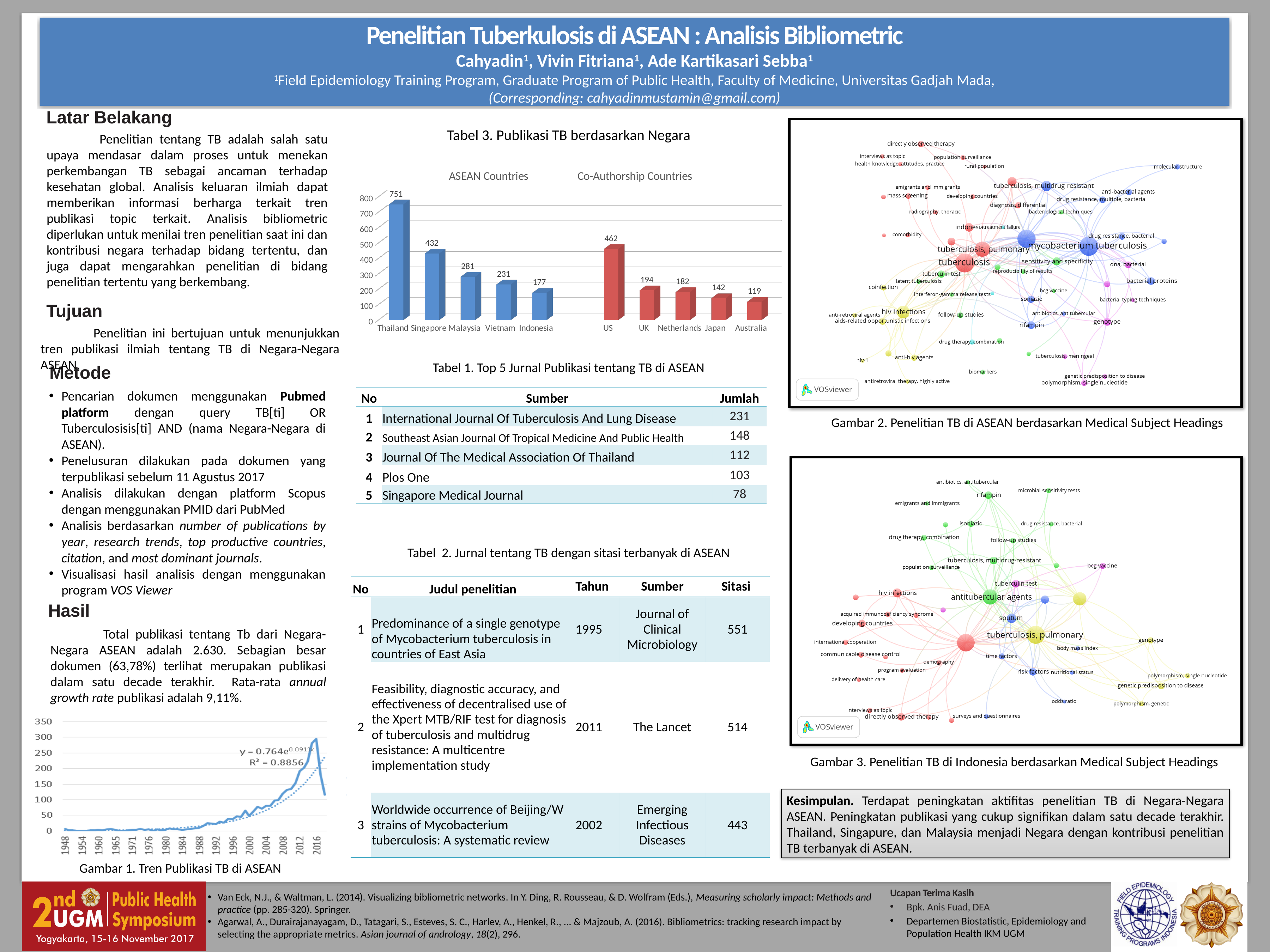
In the chart 'Gambar 1. Tren Publikasi TB di ASEAN', what R² value is printed on the chart? R² = 0.8856 In the chart titled 'Tabel 3. Publikasi TB berdasarkan Negara', which country has the highest value? Thailand In the chart titled 'Tabel 3. Publikasi TB berdasarkan Negara', which is larger, the value for Singapore or the value for US? US In the chart titled 'Tabel 3. Publikasi TB berdasarkan Negara', how many countries are shown in total? 10 In the chart titled 'Tabel 3. Publikasi TB berdasarkan Negara', which country has the lowest value? Australia In the chart titled 'Tabel 3. Publikasi TB berdasarkan Negara', what is the value for Indonesia? 177 In the chart 'Gambar 1. Tren Publikasi TB di ASEAN', do the values generally rise or fall from 1948 to 2016? Rise In the chart titled 'Tabel 3. Publikasi TB berdasarkan Negara', what is the value for Thailand? 751 What kind of chart is 'Tabel 3. Publikasi TB berdasarkan Negara'? Bar chart In the chart titled 'Tabel 3. Publikasi TB berdasarkan Negara', what is the difference between the values for Thailand and Singapore? 319 In the chart titled 'Tabel 3. Publikasi TB berdasarkan Negara', what is the value for US? 462